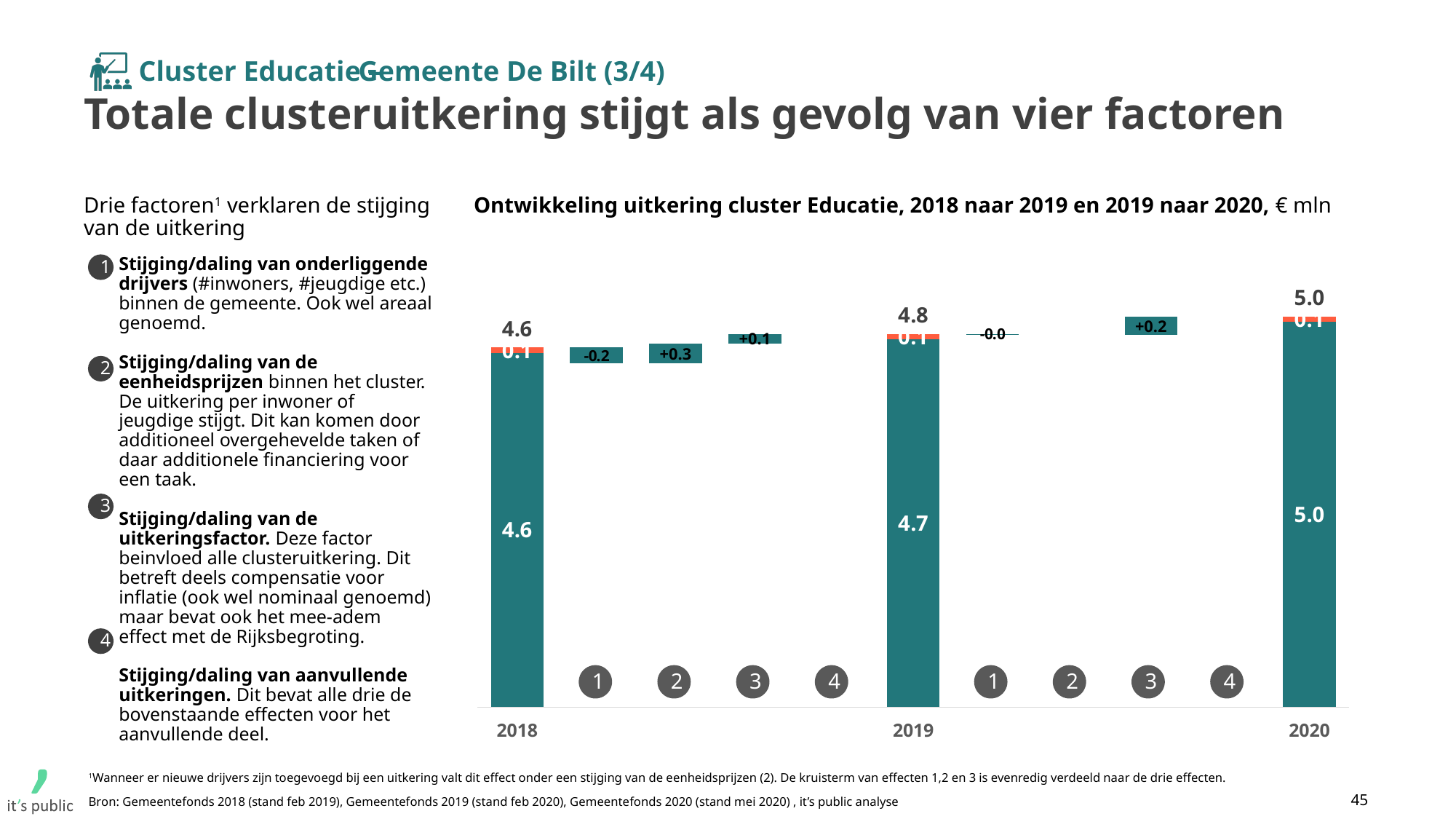
What is the effect of factor 3 between 2019 and 2020? +0.2 What is the effect of factor 1 between 2018 and 2019? -0.2 Which year has the lowest total uitkering? 2018 Does the total uitkering rise or fall from 2018 to 2020? rise What is the effect of factor 2 between 2018 and 2019? +0.3 Which year has the highest total uitkering? 2020 What is the total uitkering shown for 2019? 4.8 In what unit are the values in the chart expressed? € mln What is the total uitkering shown for 2020? 5.0 What kind of chart is shown on the slide? bar chart What is the total uitkering shown for 2018? 4.6 What is the difference between the total for 2020 and the total for 2018? 0.4